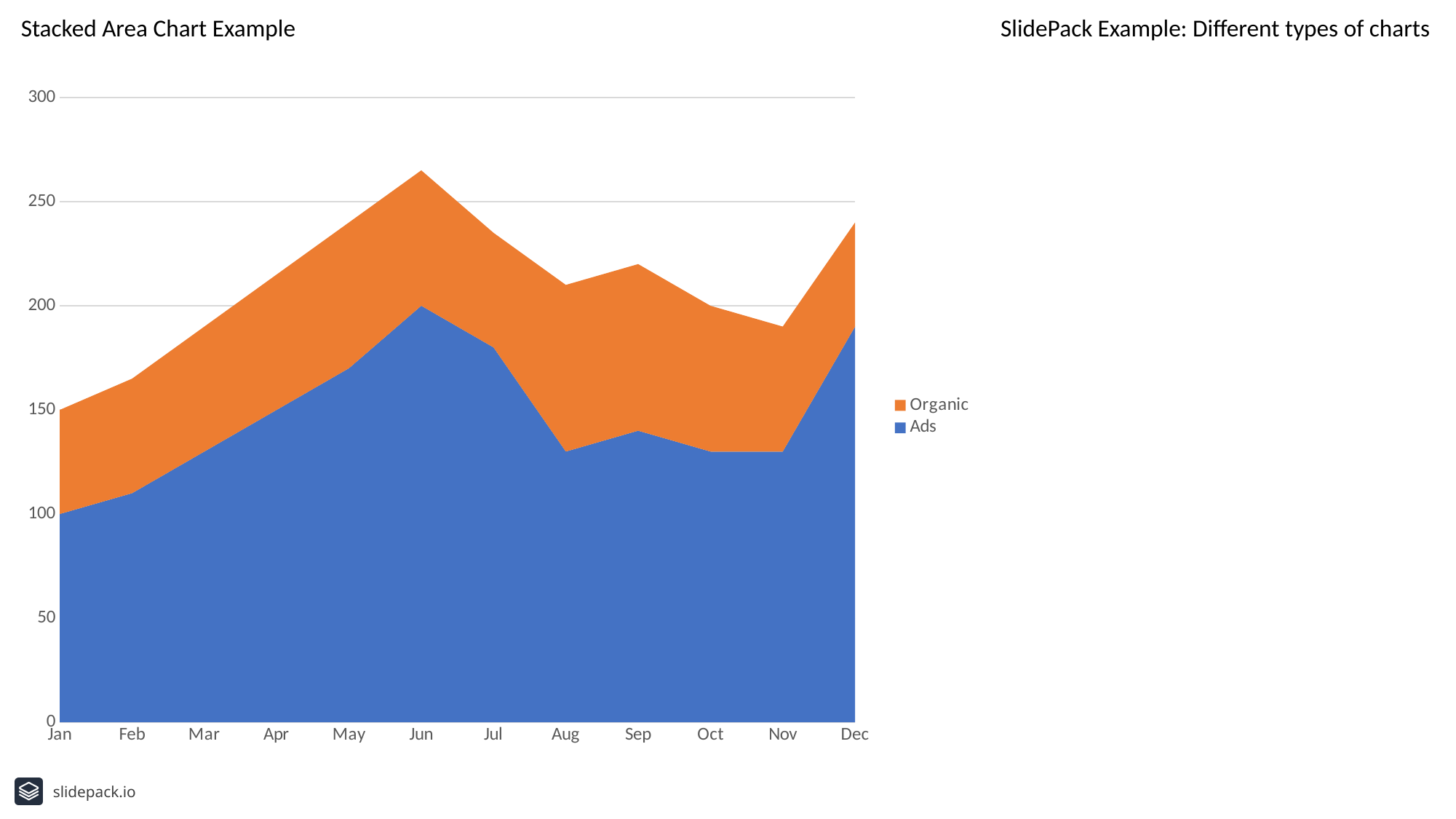
How many months are shown on the x axis? 12 What is the title of the chart? Stacked Area Chart Example Does the Ads series rise or fall from Jan to Jun? rise How many series does the legend list? 2 Is the value for Ads in Aug greater or less than 150? less In which month is the Ads series at its lowest value? Jan Which series is shown in orange? Organic In which month does the Ads series reach its highest value? Jun Is the value for Ads in Dec greater or less than 150? greater What kind of chart is shown on the slide? stacked area chart Is the combined total of Ads and Organic in Jun greater or less than 250? greater In which month is the combined total of Ads and Organic highest? Jun